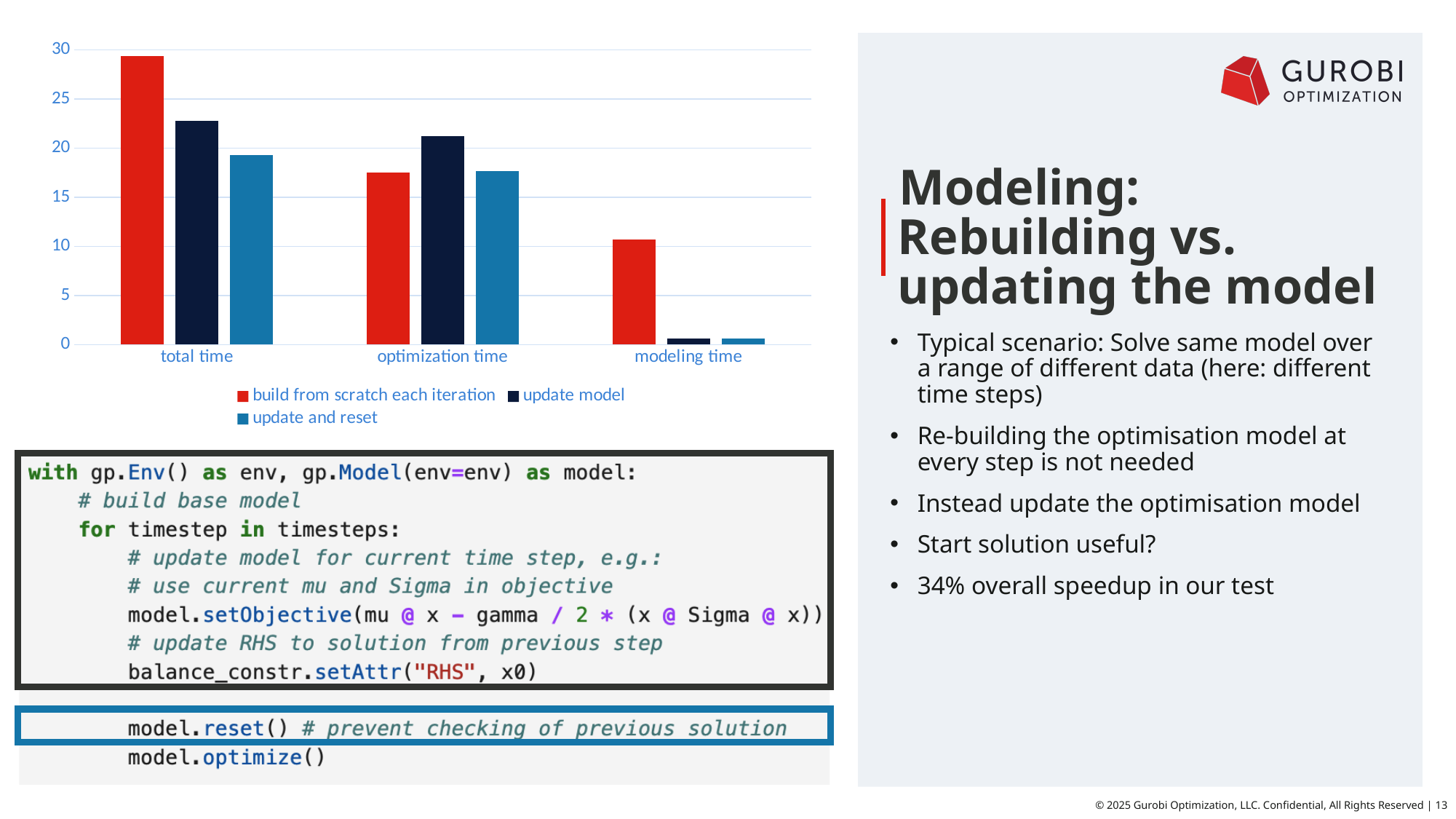
What kind of chart is shown on the slide? bar chart Is the value for 'build from scratch each iteration' in the 'modeling time' category greater or less than 10? greater Is the value for 'update and reset' in the 'total time' category greater or less than 20? less Is the value for 'build from scratch each iteration' in the 'total time' category greater or less than 25? greater Which category has the highest value for the 'build from scratch each iteration' series? total time In the 'total time' category, which is larger: 'build from scratch each iteration' or 'update model'? build from scratch each iteration How many series does the chart's legend list? 3 In the 'optimization time' category, which is larger: 'update model' or 'build from scratch each iteration'? update model Do the values for the 'build from scratch each iteration' series rise or fall from 'total time' to 'modeling time'? fall How many categories are shown on the x axis of the chart? 3 Which category has the lowest value for the 'update model' series? modeling time